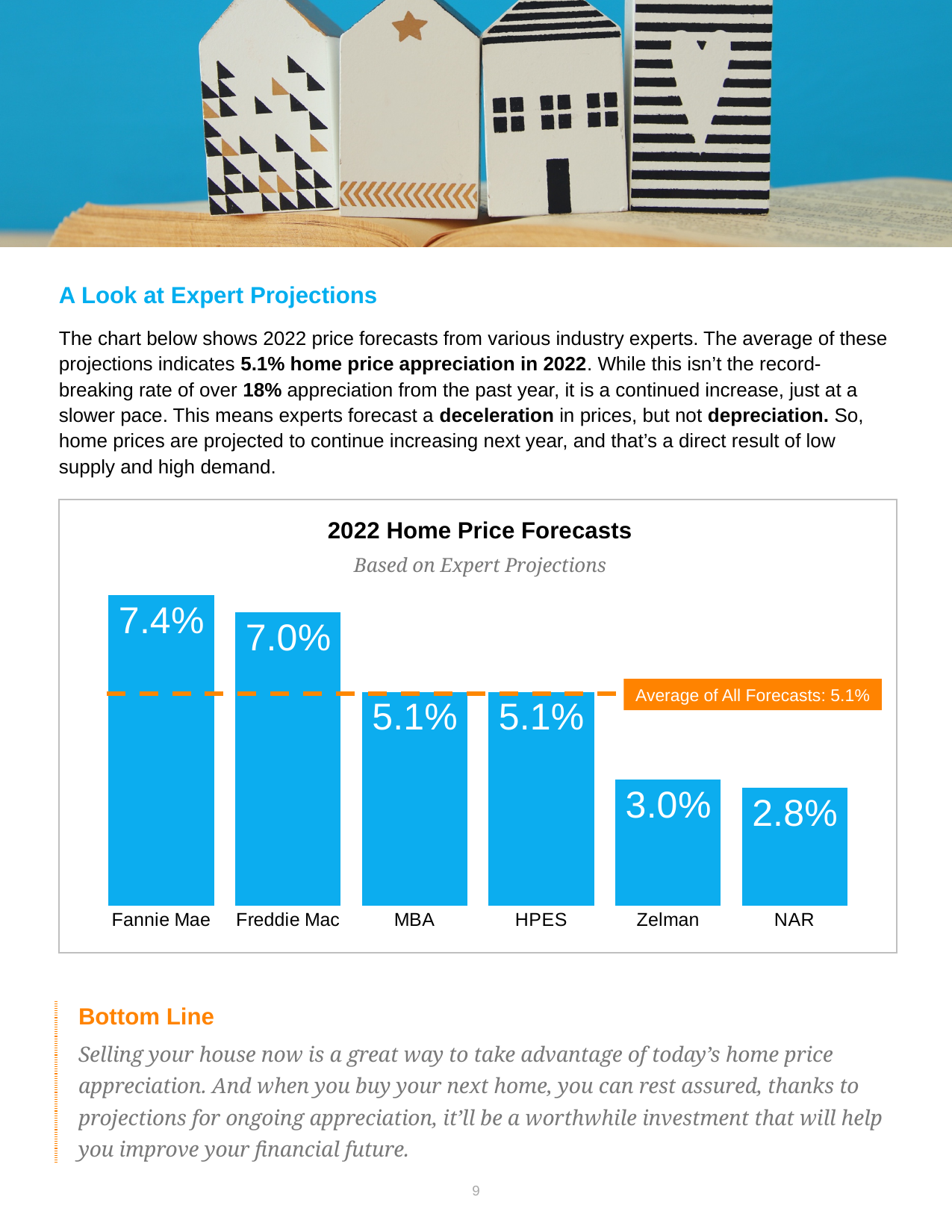
What is the 2022 home price forecast from Fannie Mae? 7.4% What kind of chart is used to show the 2022 home price forecasts? Bar chart Which forecaster has the highest 2022 home price forecast? Fannie Mae What is the average of all forecasts shown on the chart? 5.1% What is the difference between the Fannie Mae and Freddie Mac forecasts? 0.4% What is the difference between the MBA forecast and the NAR forecast? 2.3% How many forecasters are shown in the chart? 6 What is the 2022 home price forecast from NAR? 2.8% What is the 2022 home price forecast from Zelman? 3.0% Which forecaster has the lowest 2022 home price forecast? NAR What is the title of the chart? 2022 Home Price Forecasts Which is larger, the Freddie Mac forecast or the HPES forecast? Freddie Mac